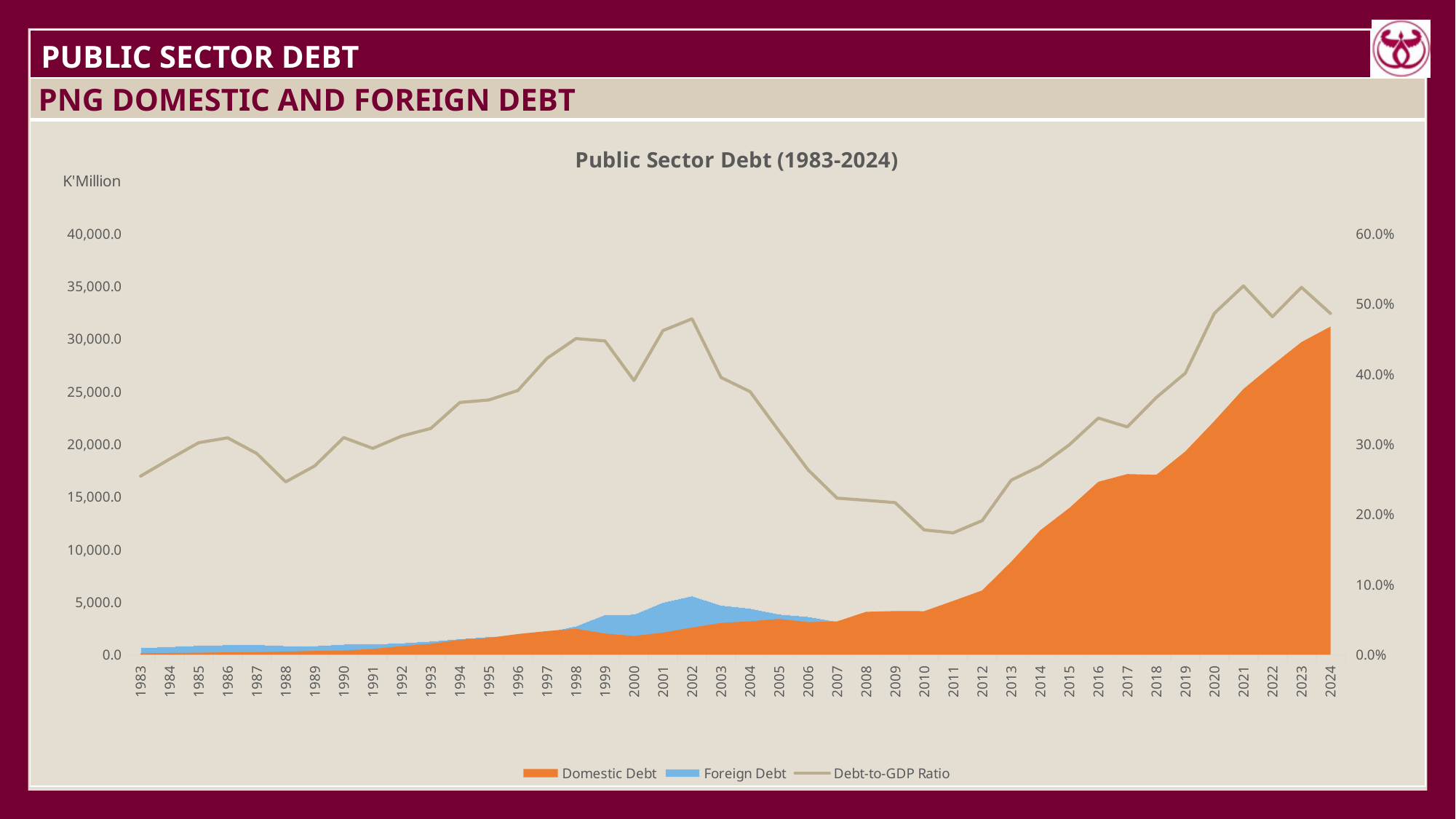
What kind of chart is shown on the slide? Area chart with a line In which year is Domestic Debt highest? 2024 How many series does the legend list? 3 How many years are plotted along the x axis? 42 Which year has the larger Debt-to-GDP Ratio, 2002 or 2010? 2002 Is the Debt-to-GDP Ratio for 2021 greater or less than 40.0%? greater What unit is shown for the left-hand axis? K'Million What is the title of the chart? Public Sector Debt (1983-2024) Does the Debt-to-GDP Ratio rise or fall from 2002 to 2011? fall Is the Debt-to-GDP Ratio for 2011 greater or less than 20.0%? less Is the Domestic Debt value for 2024 greater or less than 25,000.0? greater Does Domestic Debt rise or fall from 2012 to 2024? rise